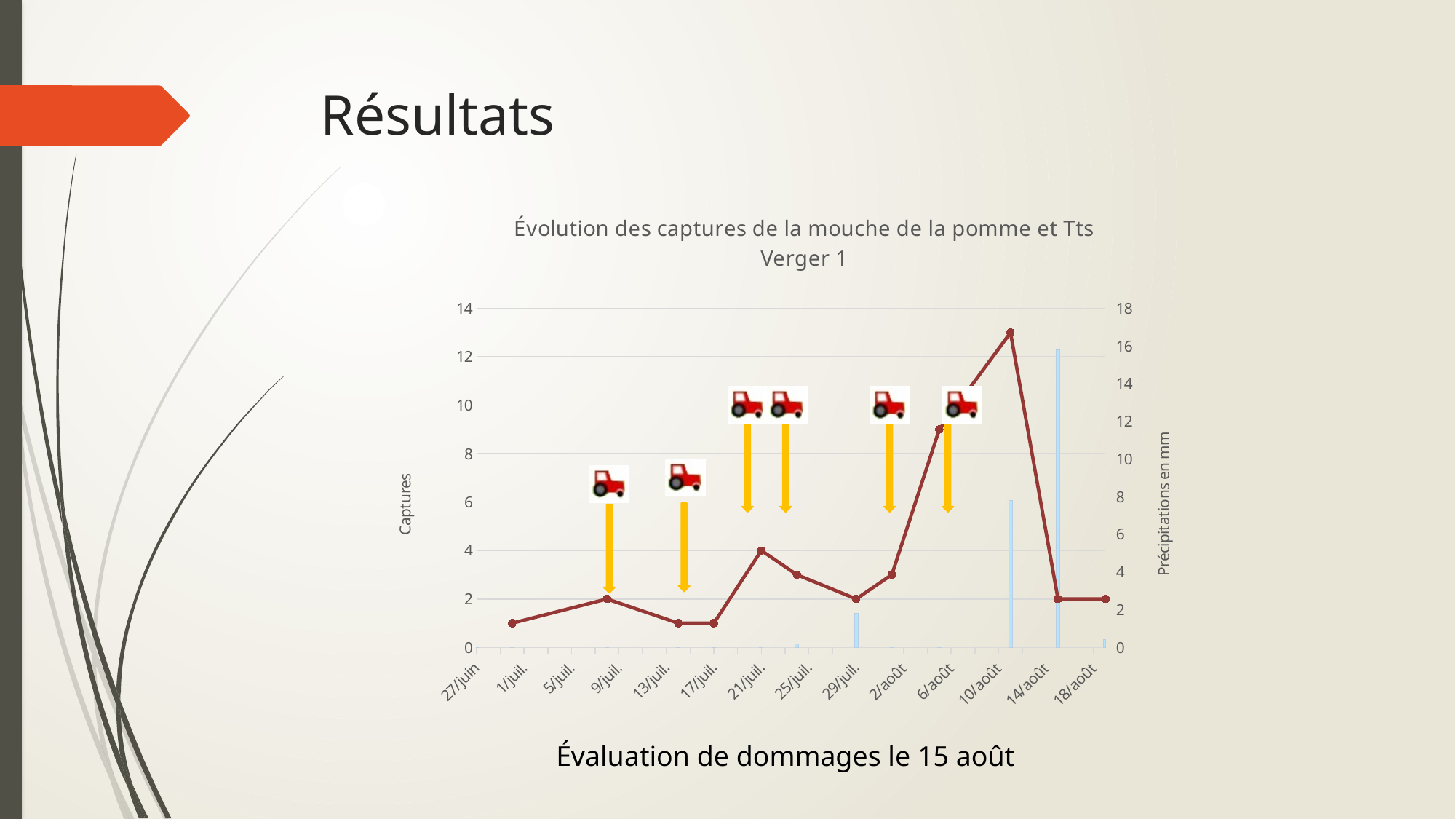
What kind of chart is shown on the slide? A combined line and bar chart Is the highest value of the captures line greater or less than 12? greater How many captures are plotted on 9/juil.? 2 Which date has more captures, 6/août or 25/juil.? 6/août What is the label of the left vertical axis? Captures Do the captures rise or fall between 2/août and the peak of the line? rise Is the tallest precipitation bar greater or less than 14 mm? greater What is the title of the chart? Évolution des captures de la mouche de la pomme et Tts Verger 1